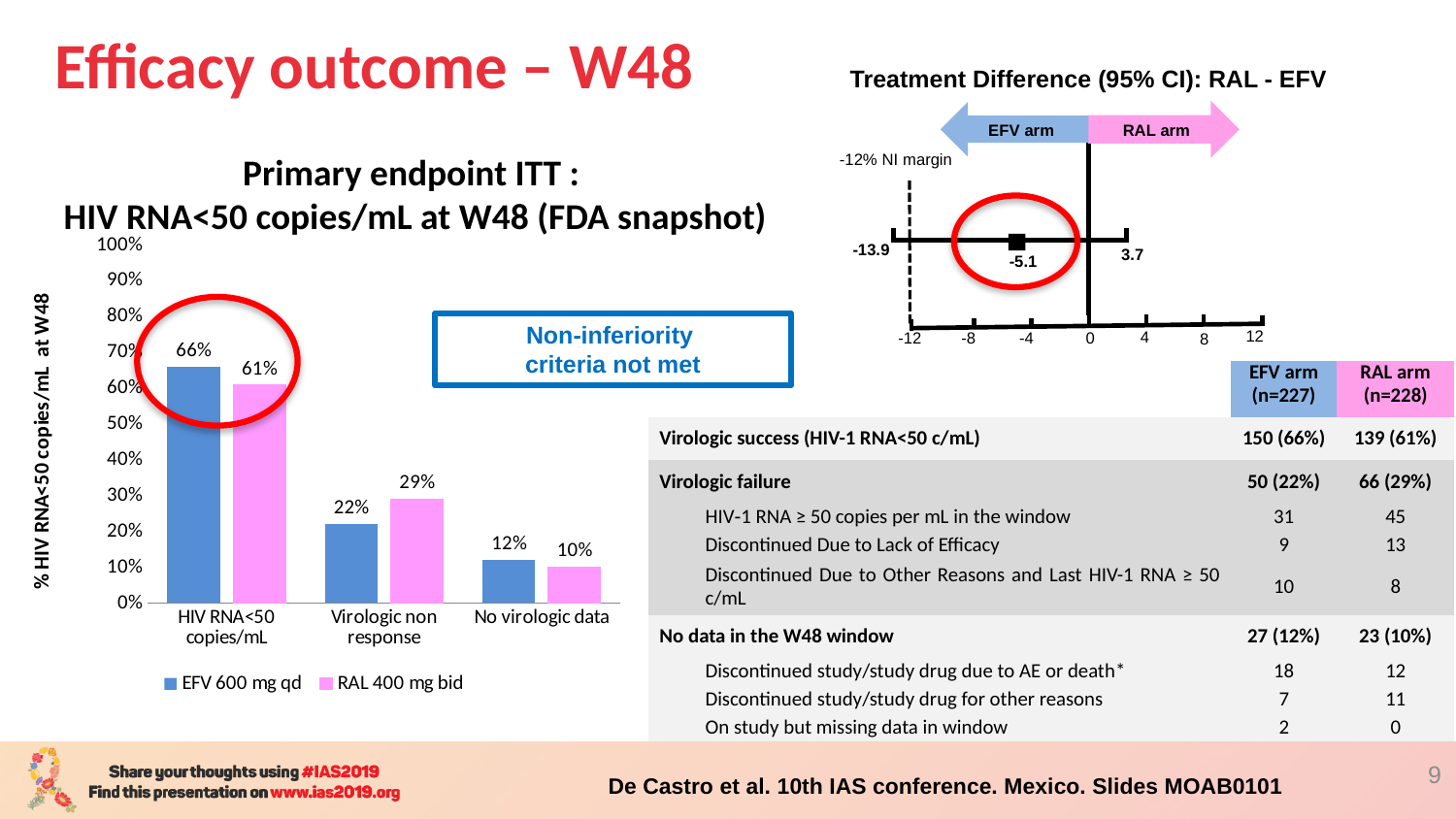
In the bar chart on the left, how many series does the legend list? 2 In the bar chart on the left, what is the value for EFV 600 mg qd in the No virologic data category? 12% In the bar chart titled 'Primary endpoint ITT: HIV RNA<50 copies/mL at W48 (FDA snapshot)', what is the value for EFV 600 mg qd in the HIV RNA<50 copies/mL category? 66% In the 'Treatment Difference (95% CI): RAL - EFV' chart, what is the point estimate of the treatment difference? -5.1 In the bar chart on the left, what is the value for RAL 400 mg bid in the Virologic non response category? 29% In the bar chart on the left, which category has the lowest value for RAL 400 mg bid? No virologic data In the bar chart on the left, what is the difference between the EFV 600 mg qd and RAL 400 mg bid values in the HIV RNA<50 copies/mL category? 5% In the bar chart on the left, how many categories are shown on the x axis? 3 In the 'Treatment Difference (95% CI): RAL - EFV' chart, what is the lower bound of the 95% confidence interval? -13.9 In the bar chart on the left, what is the value for RAL 400 mg bid in the HIV RNA<50 copies/mL category? 61% What kind of chart is the chart on the left of the slide? Bar chart In the bar chart on the left, which series has the larger value in the Virologic non response category? RAL 400 mg bid